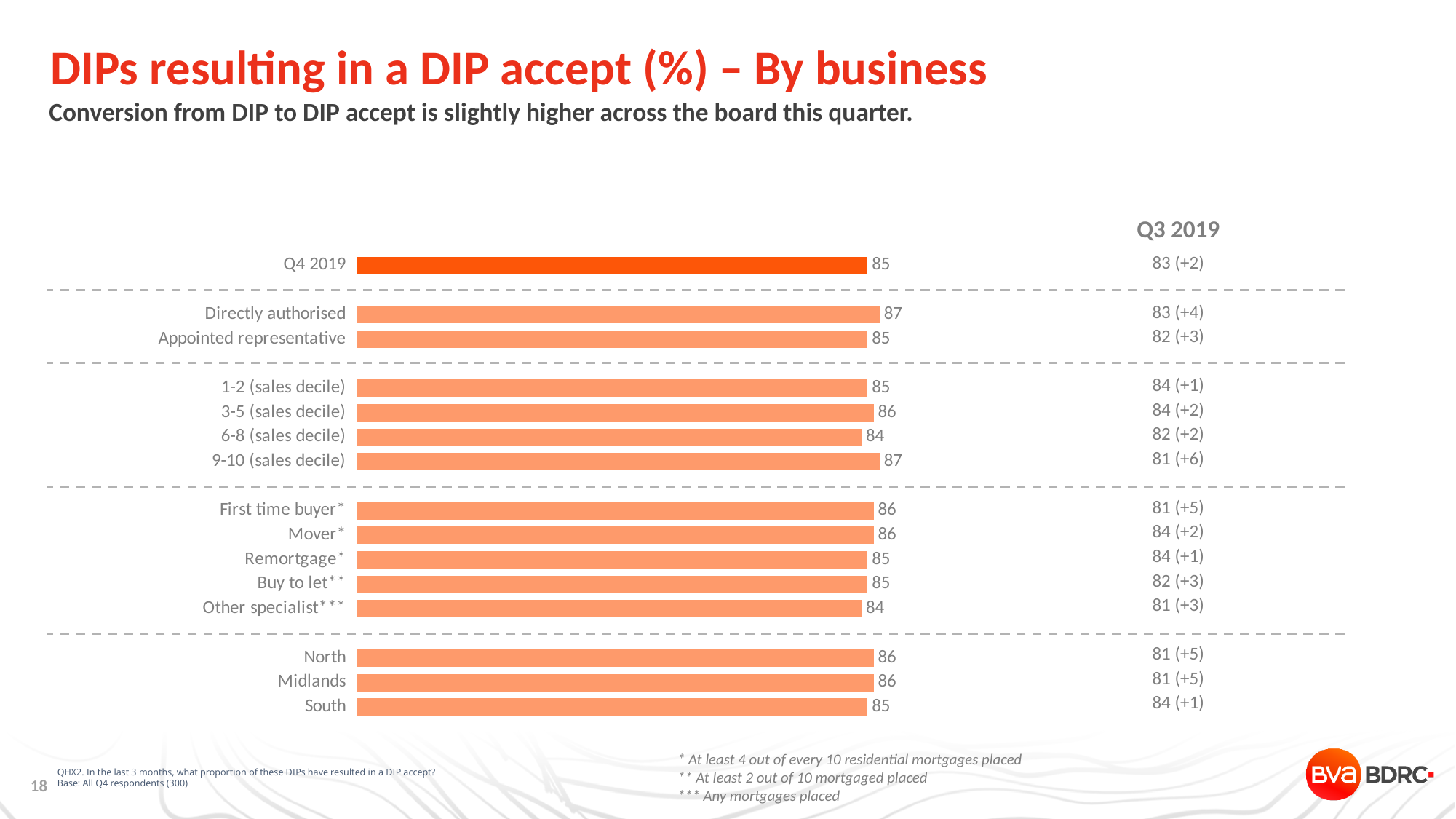
What is the difference between the values for Directly authorised and Appointed representative? 2 What is the value for Directly authorised? 87 What is the title of the slide's chart? DIPs resulting in a DIP accept (%) – By business What is the value for 6-8 (sales decile)? 84 What Q3 2019 value is shown for 9-10 (sales decile)? 81 (+6) What is the value for Midlands? 86 What kind of chart is shown on the slide? Bar chart Among the sales decile categories, which has the highest value? 9-10 (sales decile) How many bars are plotted in the chart? 15 What is the value for the overall Q4 2019 bar? 85 Which is larger, the value for 9-10 (sales decile) or the value for 6-8 (sales decile)? 9-10 (sales decile) Among the sales decile categories, which has the lowest value? 6-8 (sales decile)